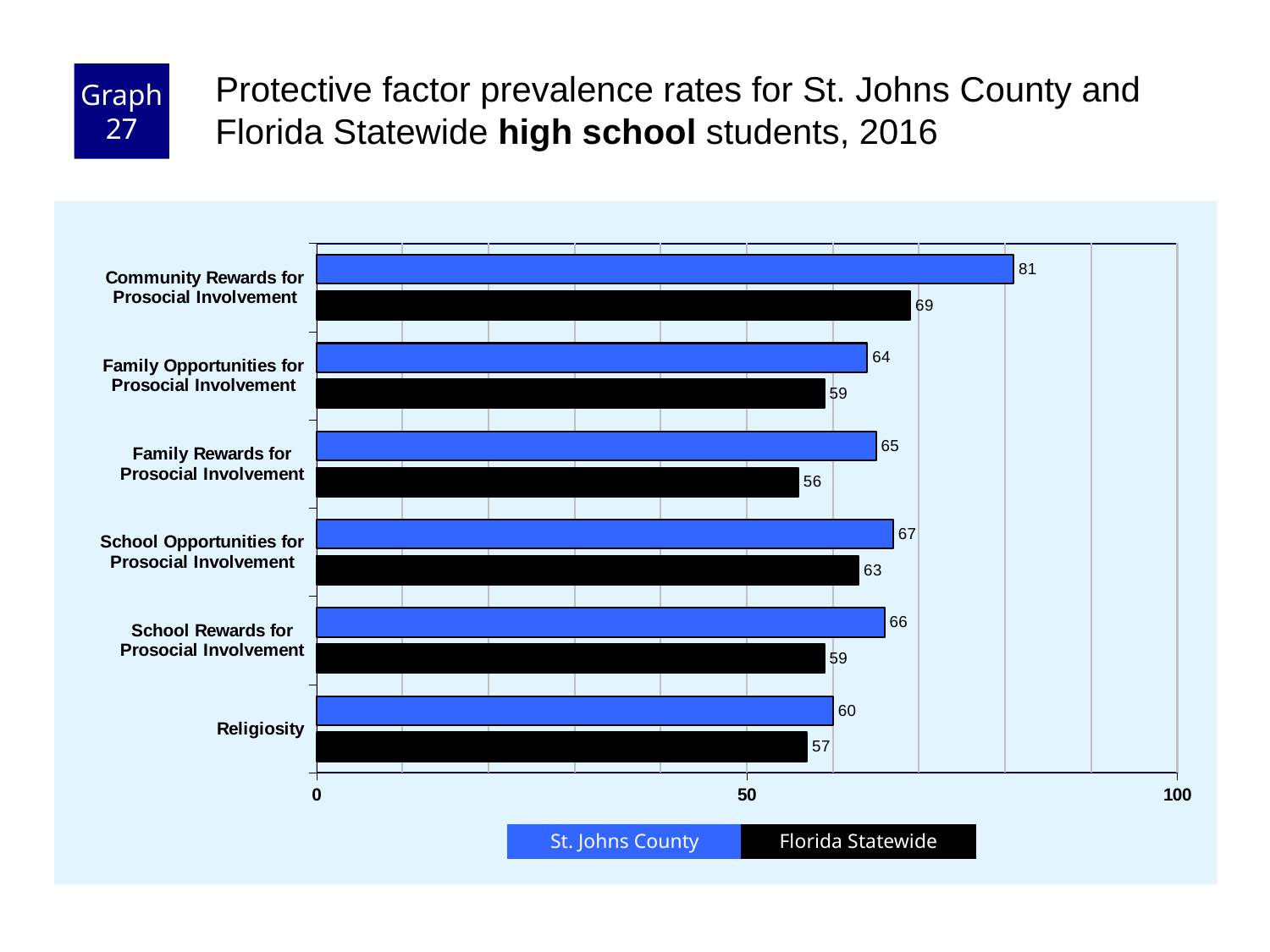
How many categories are shown on the chart? 6 What is the St. Johns County value for Religiosity? 60 Which colour represents Florida Statewide in the chart? Black Which category has the highest St. Johns County value? Community Rewards for Prosocial Involvement What is the St. Johns County value for Community Rewards for Prosocial Involvement? 81 What kind of chart is shown on the slide? Bar chart What is the Florida Statewide value for Family Rewards for Prosocial Involvement? 56 What is the difference between the St. Johns County and Florida Statewide values for Community Rewards for Prosocial Involvement? 12 Is the Florida Statewide value for Religiosity greater or less than 50? greater Which category has the lowest Florida Statewide value? Family Rewards for Prosocial Involvement How many series does the legend list? 2 Which is larger for School Opportunities for Prosocial Involvement: St. Johns County or Florida Statewide? St. Johns County